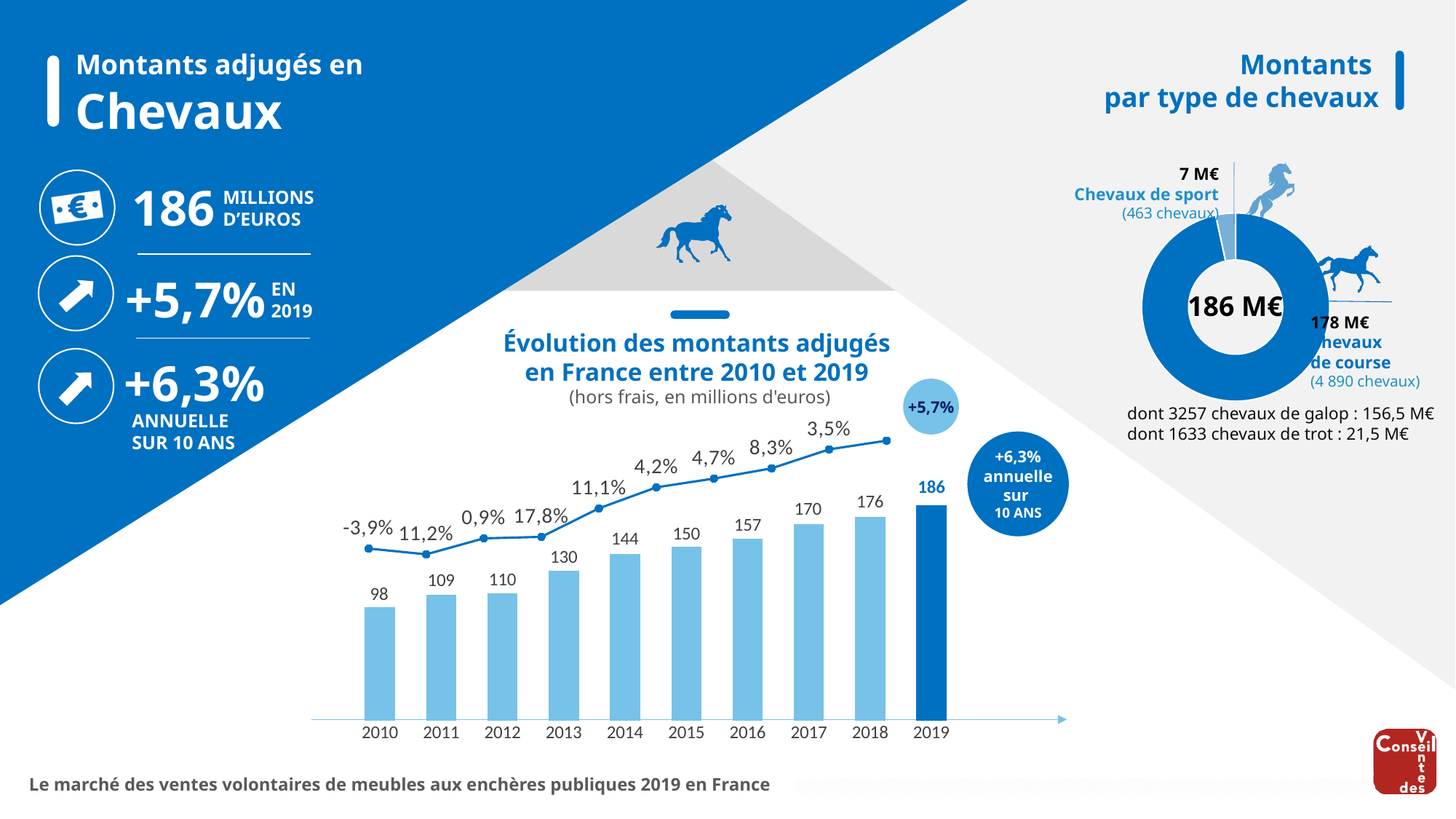
In the chart 'Montants par type de chevaux', what is the amount for Chevaux de sport? 7 M€ In the chart 'Évolution des montants adjugés en France entre 2010 et 2019', what is the difference between the bar values for 2018 and 2017? 6 In the chart 'Évolution des montants adjugés en France entre 2010 et 2019', what is the value of the bar for 2019? 186 In the chart 'Évolution des montants adjugés en France entre 2010 et 2019', do the bar values rise or fall from 2010 to 2019? rise In the chart 'Évolution des montants adjugés en France entre 2010 et 2019', which year has the lowest bar? 2010 In the chart 'Montants par type de chevaux', what is the amount for Chevaux de course? 178 M€ In the chart 'Évolution des montants adjugés en France entre 2010 et 2019', what is the value of the bar for 2014? 144 In the chart 'Évolution des montants adjugés en France entre 2010 et 2019', what percentage is shown on the line for 2013? 17,8% In the chart 'Évolution des montants adjugés en France entre 2010 et 2019', which is larger, the bar for 2015 or the bar for 2016? 2016 What kind of chart is 'Montants par type de chevaux'? donut chart In the chart 'Évolution des montants adjugés en France entre 2010 et 2019', which year has the highest bar? 2019 In the chart 'Évolution des montants adjugés en France entre 2010 et 2019', how many years are shown on the x axis? 10